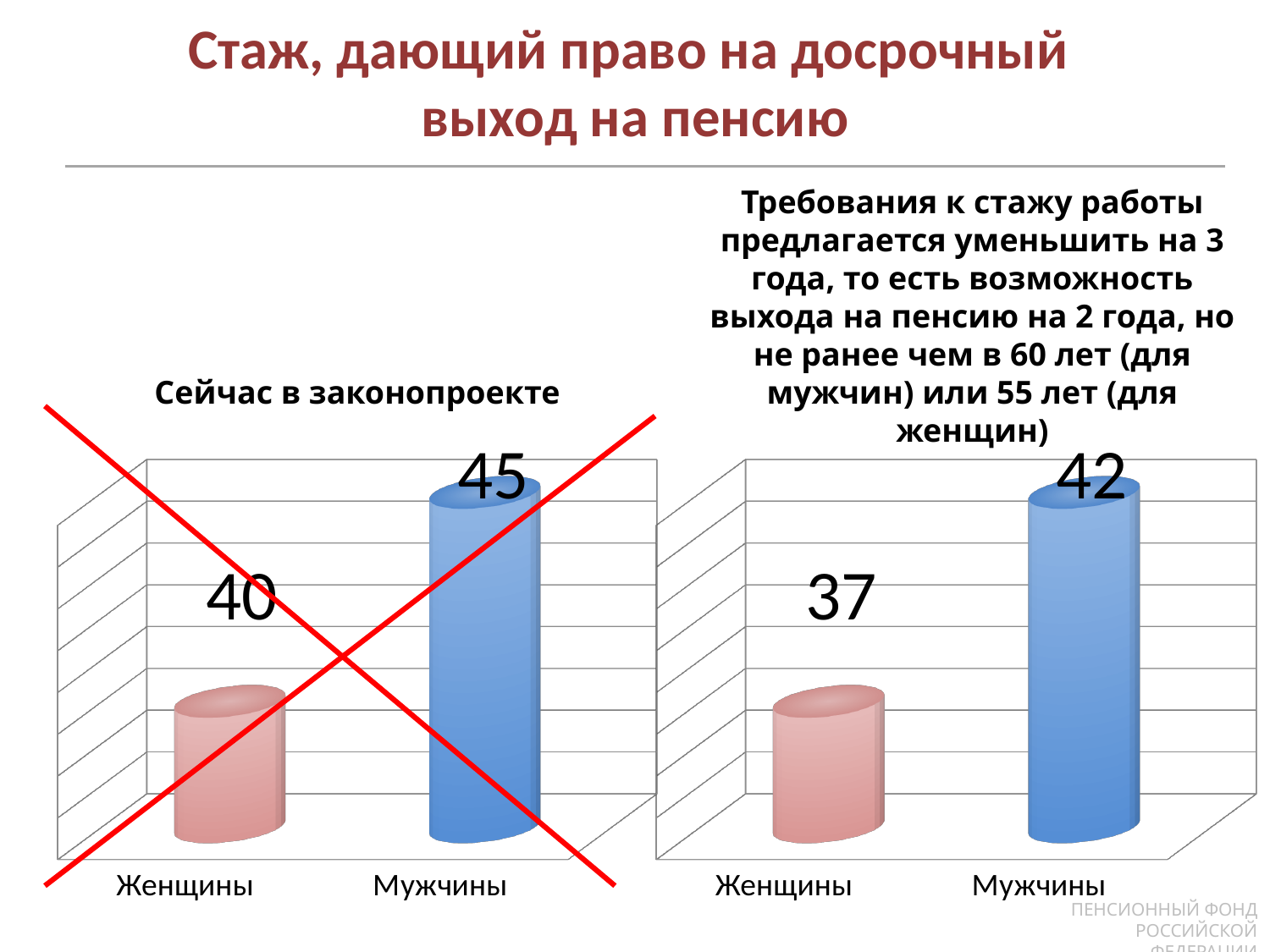
In the right chart, which category has the lowest value? Женщины How many categories are shown in the right chart? 2 In the left chart titled "Сейчас в законопроекте", what is the value for Женщины? 40 Comparing the two charts, is the value for Женщины larger in the left chart or the right chart? left chart In the left chart titled "Сейчас в законопроекте", what is the value for Мужчины? 45 In the left chart titled "Сейчас в законопроекте", what is the difference between the values for Мужчины and Женщины? 5 What is the title of the left chart? Сейчас в законопроекте What kind of chart is the left chart titled "Сейчас в законопроекте"? bar chart In the right chart, what is the value for Женщины? 37 In the right chart, what is the value for Мужчины? 42 In the right chart, what is the difference between the values for Мужчины and Женщины? 5 In the left chart titled "Сейчас в законопроекте", which category has the highest value? Мужчины